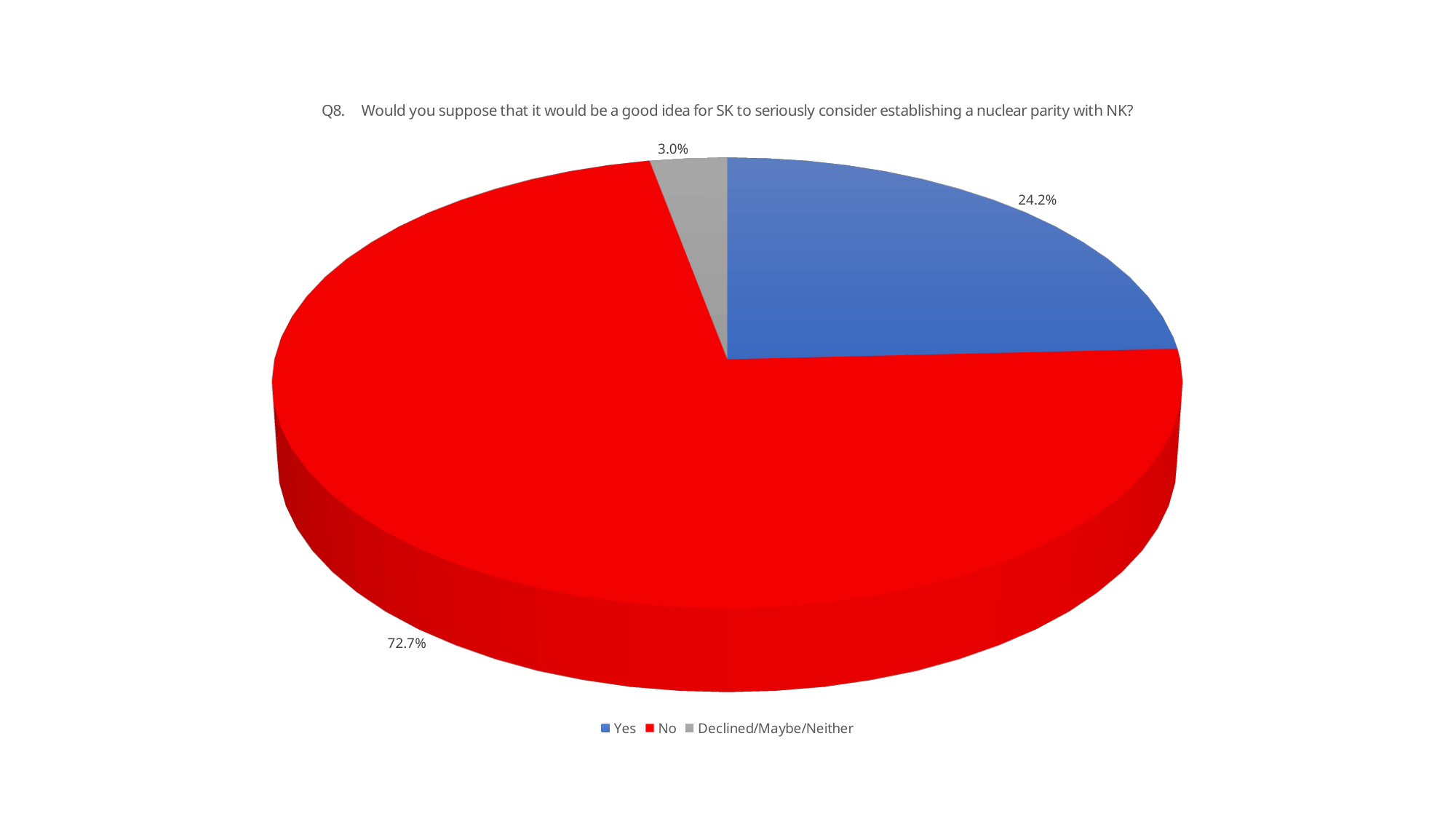
What kind of chart is shown on the slide? pie chart How many entries does the legend list? 3 What percentage of respondents are in the "Declined/Maybe/Neither" category? 3.0% What percentage of respondents answered "Yes"? 24.2% What percentage of respondents answered "No"? 72.7% What colour is the "No" slice? red Which is larger, the "Yes" slice or the "Declined/Maybe/Neither" slice? Yes Which response category has the smallest share of the pie? Declined/Maybe/Neither How many categories does the pie chart have? 3 Which response category has the largest share of the pie? No What is the question number shown in the chart title? Q8 What is the difference in percentage points between the "No" and "Yes" slices? 48.5